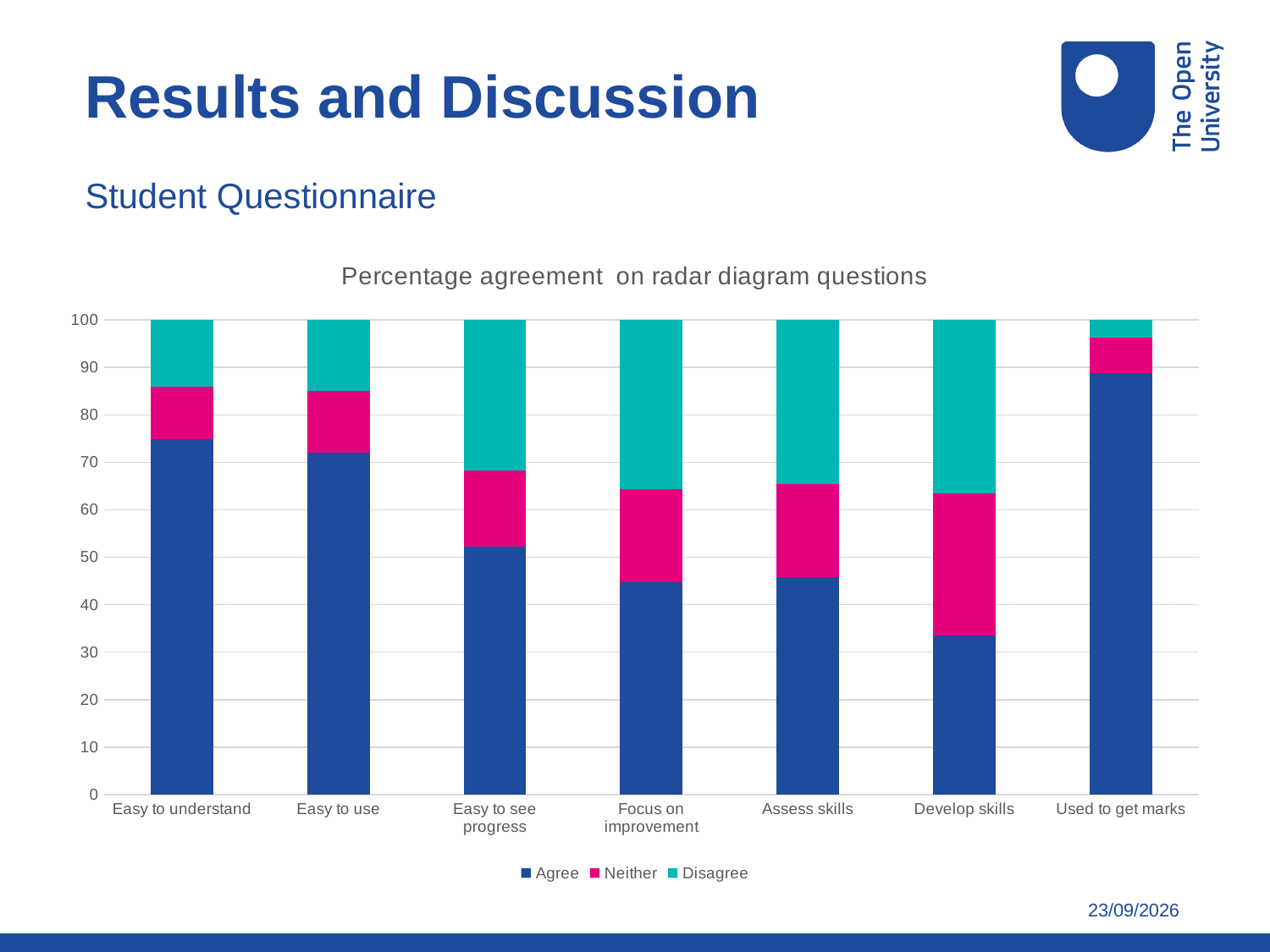
Which category has the smallest Disagree segment? Used to get marks Which category has the highest Agree value? Used to get marks How many questions (categories) are shown along the x axis? 7 Which category has the lowest Agree value? Develop skills Which has the larger Agree value, Easy to understand or Focus on improvement? Easy to understand What is the total height of the stacked bar for Easy to use? 100 What kind of chart is shown on the slide? Stacked bar chart Which category has the largest Neither segment? Develop skills Is the Agree value for Easy to understand greater or less than 70? greater Is the Agree value for Develop skills greater or less than 40? less How many series does the legend list? 3 What is the title of the chart? Percentage agreement on radar diagram questions